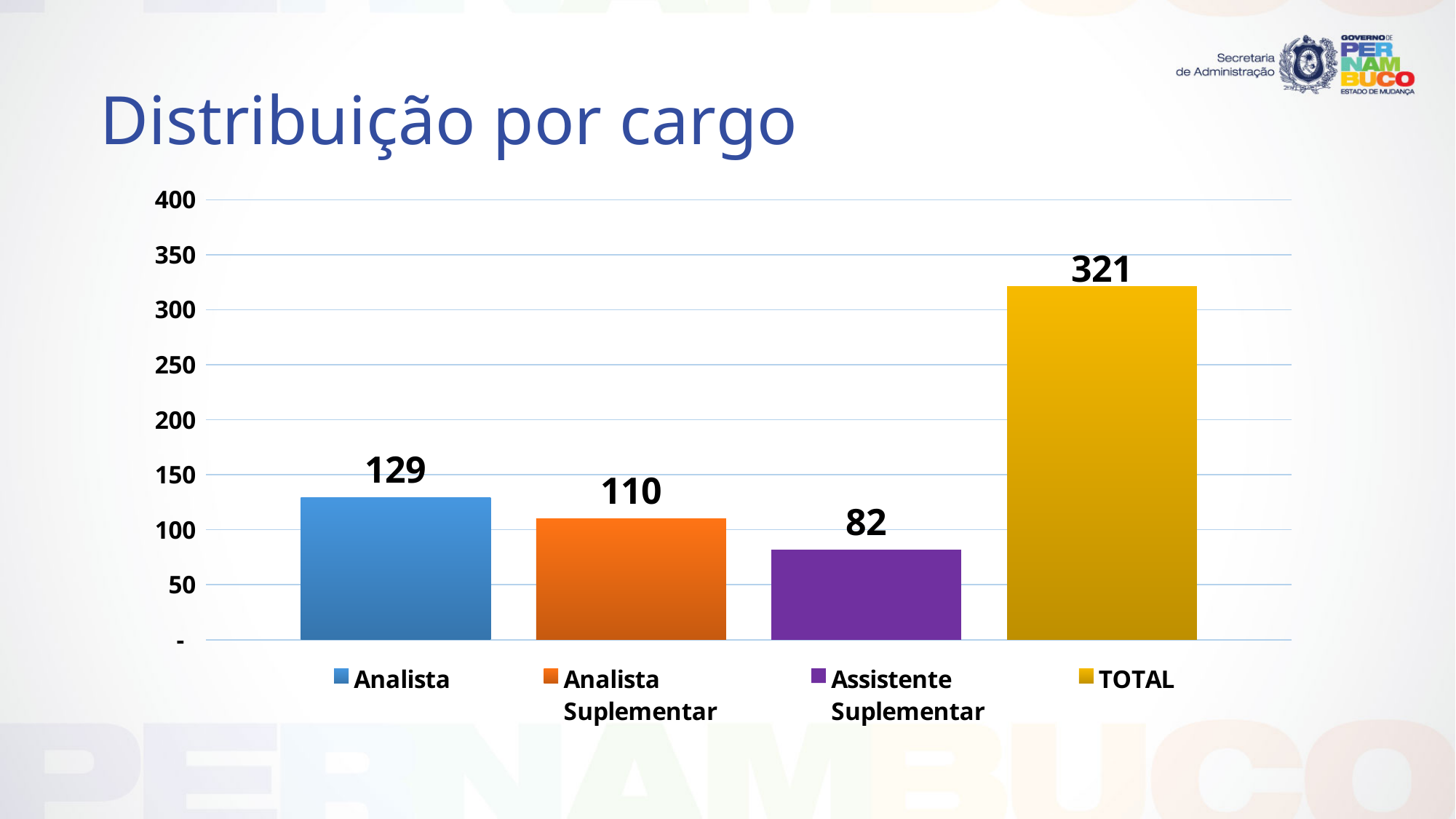
What is the title of the slide? Distribuição por cargo What kind of chart is shown on the slide? Bar chart Which category has the lowest value? Assistente Suplementar What is the difference between the values for Analista Suplementar and Assistente Suplementar? 28 What is the value for TOTAL? 321 How many bars are shown in the chart? 4 What is the value for Analista Suplementar? 110 Which category has the highest value? TOTAL Which is larger, the value for Analista or the value for Assistente Suplementar? Analista What is the value for Analista? 129 What is the difference between the values for Analista and Analista Suplementar? 19 What is the value for Assistente Suplementar? 82